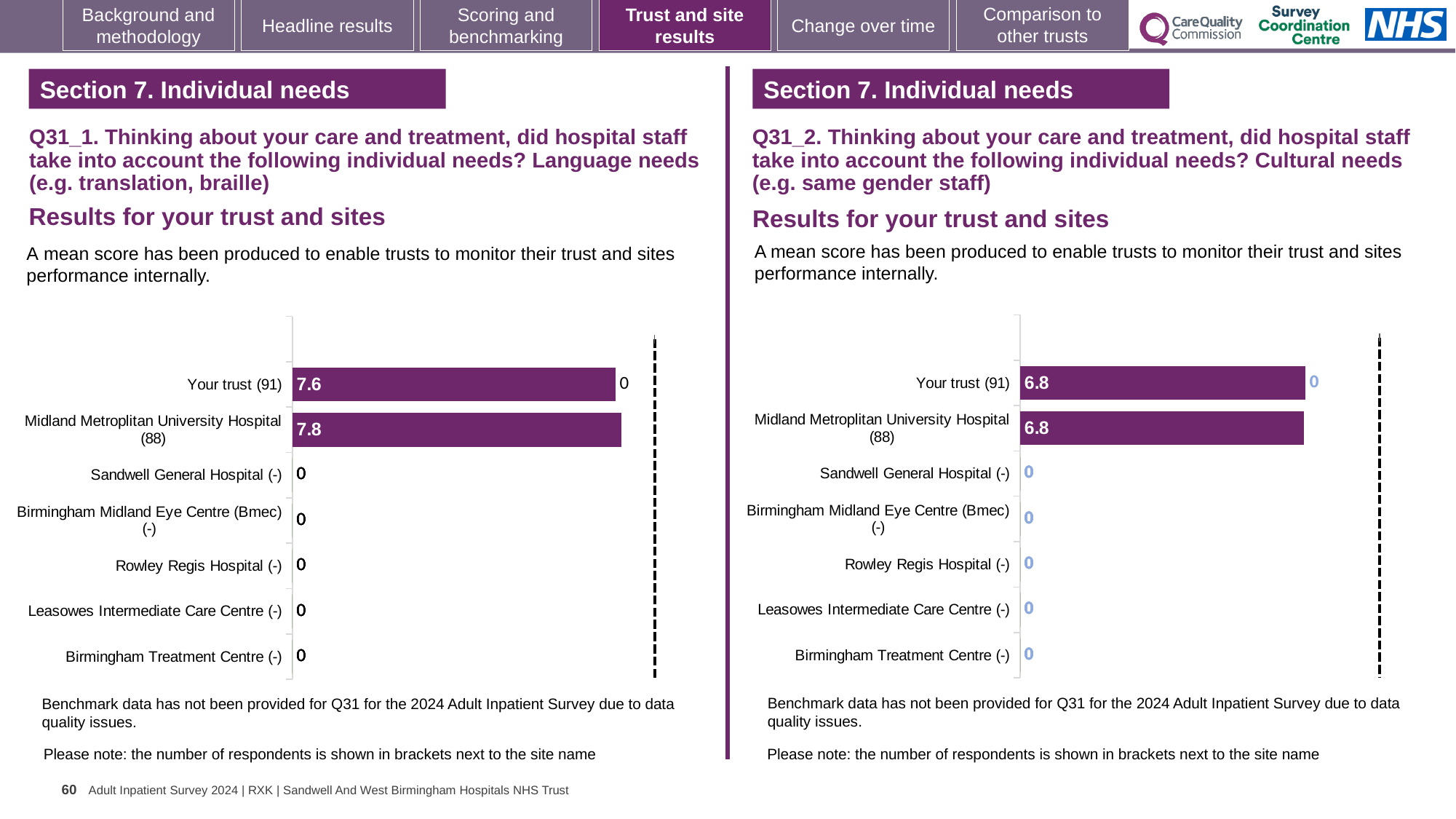
In the Q31_1 chart on the left (Language needs), how many respondents are shown in brackets for Midland Metropolitan University Hospital? 88 In the Q31_1 chart on the left (Language needs), which category has the highest mean score? Midland Metropolitan University Hospital (88) How many categories are listed on the y axis of the Q31_1 chart on the left (Language needs)? 7 In the Q31_1 chart on the left (Language needs), what is the mean score for Midland Metropolitan University Hospital (88)? 7.8 What type of chart is used in the Q31_2 chart on the right (Cultural needs)? Bar chart In the Q31_1 chart on the left (Language needs), what is the difference between the mean score for Midland Metropolitan University Hospital (88) and Your trust (91)? 0.2 In the Q31_2 chart on the right (Cultural needs), what is the mean score for Midland Metropolitan University Hospital (88)? 6.8 In the Q31_1 chart on the left (Language needs), what is the mean score for Your trust (91)? 7.6 In the Q31_2 chart on the right (Cultural needs), what is the mean score for Your trust (91)? 6.8 In the Q31_1 chart on the left (Language needs), which is larger: the mean score for Your trust (91) or for Midland Metropolitan University Hospital (88)? Midland Metropolitan University Hospital (88) Which is larger: the mean score for Your trust (91) in the Q31_1 chart on the left or the mean score for Your trust (91) in the Q31_2 chart on the right? Q31_1 chart on the left In the Q31_2 chart on the right (Cultural needs), what is the difference between the mean score for Your trust (91) and Midland Metropolitan University Hospital (88)? 0